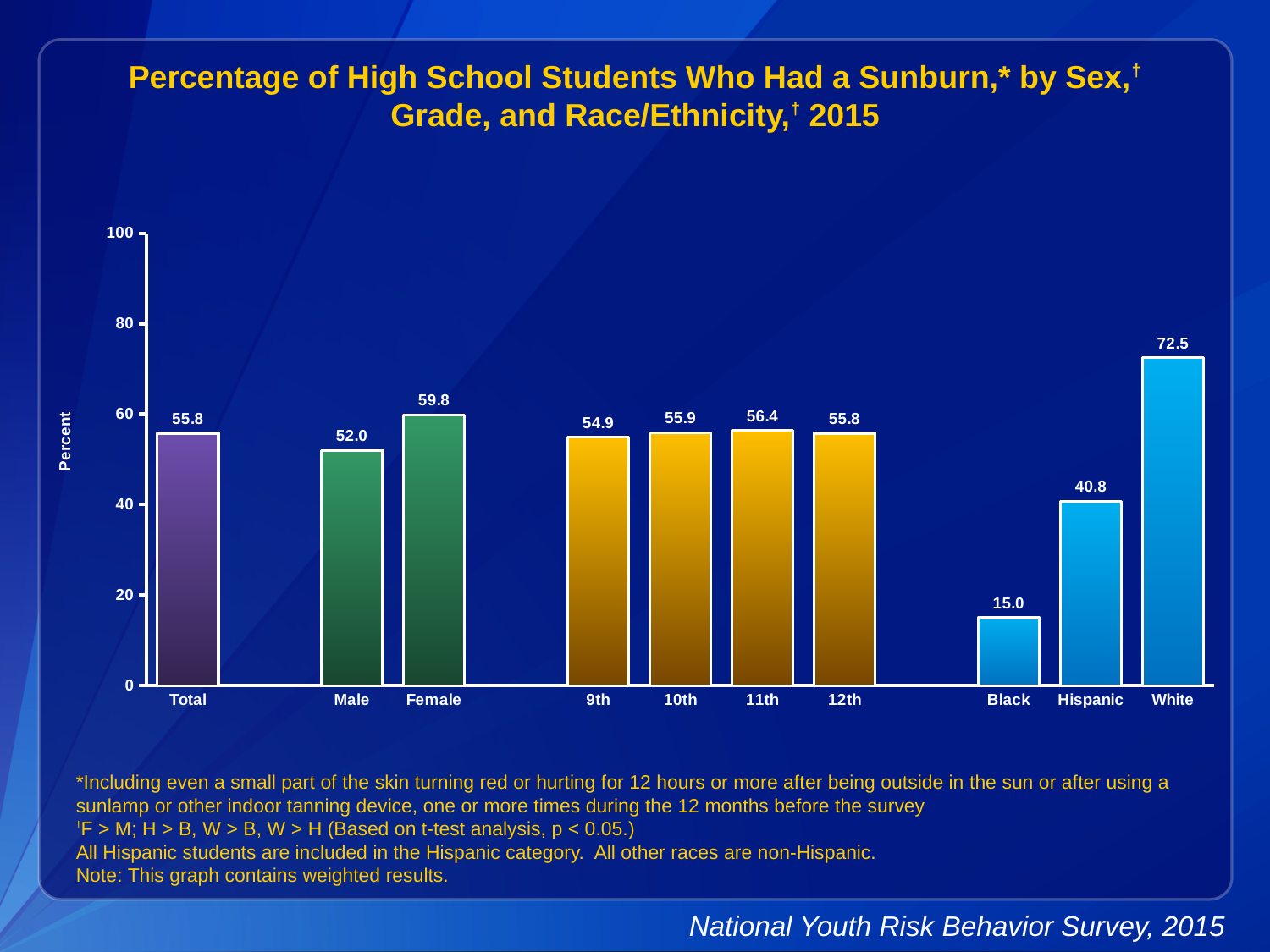
What is the label on the y axis? Percent What kind of chart is this? bar chart What is the value for Black? 15.0 Which category has the lowest value? Black What is the value for Female? 59.8 Which category has the highest value? White Is the value for Hispanic greater or less than 40? greater How many categories are shown on the x axis? 10 What is the difference between the values for White and Hispanic? 31.7 What is the value for 11th grade? 56.4 What is the difference between the values for Female and Male? 7.8 Which is larger, the value for 9th grade or the value for 12th grade? 12th